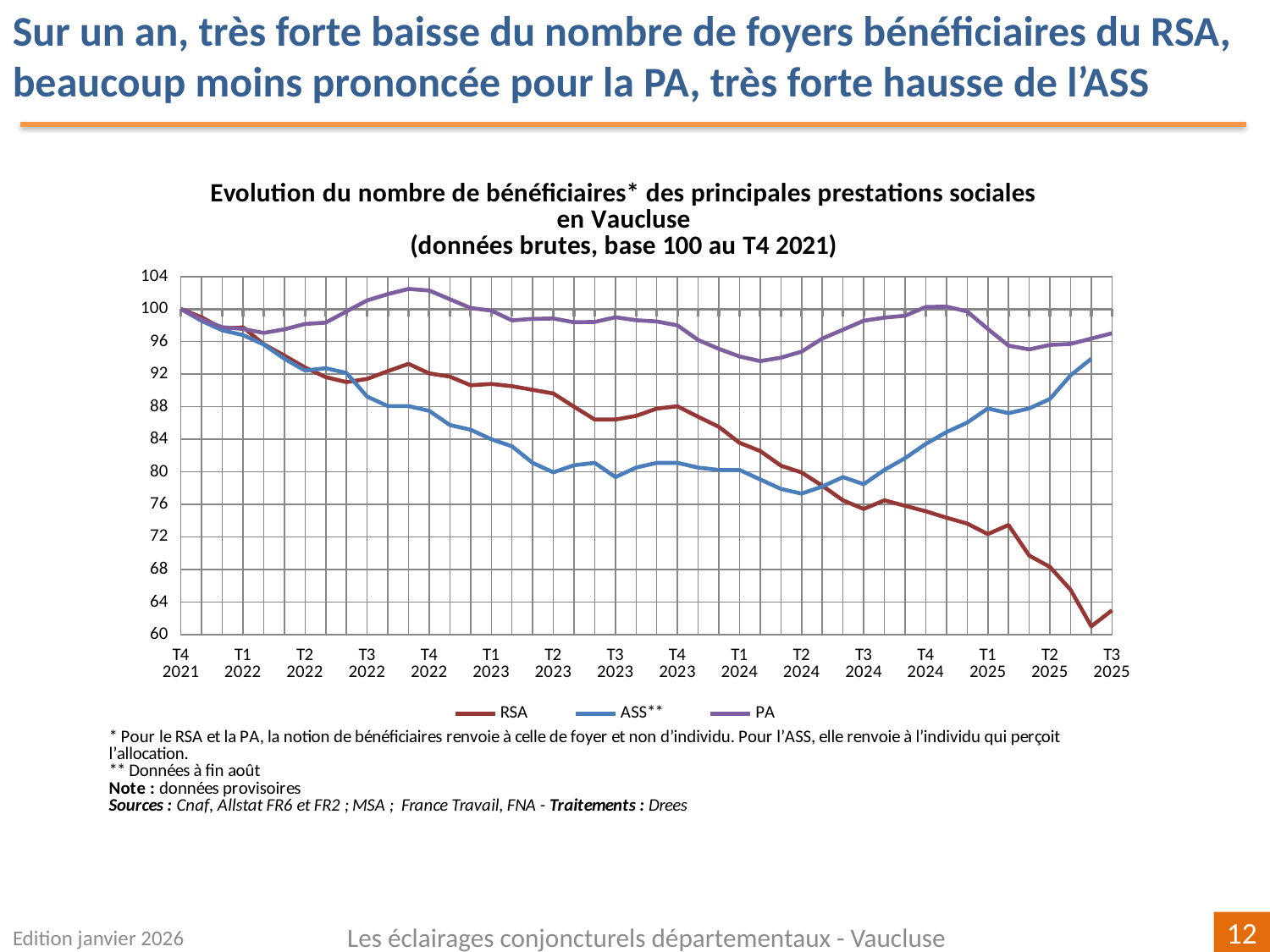
Does the RSA series rise or fall overall from T4 2021 to T3 2025? Fall How many series does the legend list? 3 Does the ASS** series rise or fall from T2 2024 to T3 2025? Rise Is the value for PA at T3 2025 greater or less than 100? less What kind of chart is shown on the slide? Line chart Which series has the highest value at T3 2025? PA Which series are listed in the legend? RSA, ASS**, PA At T4 2023, which is larger, the value for RSA or the value for ASS**? RSA Which series has the lowest value at T3 2025? RSA Is the value for RSA at T3 2025 greater or less than 68? less How many quarter labels are shown on the x axis? 16